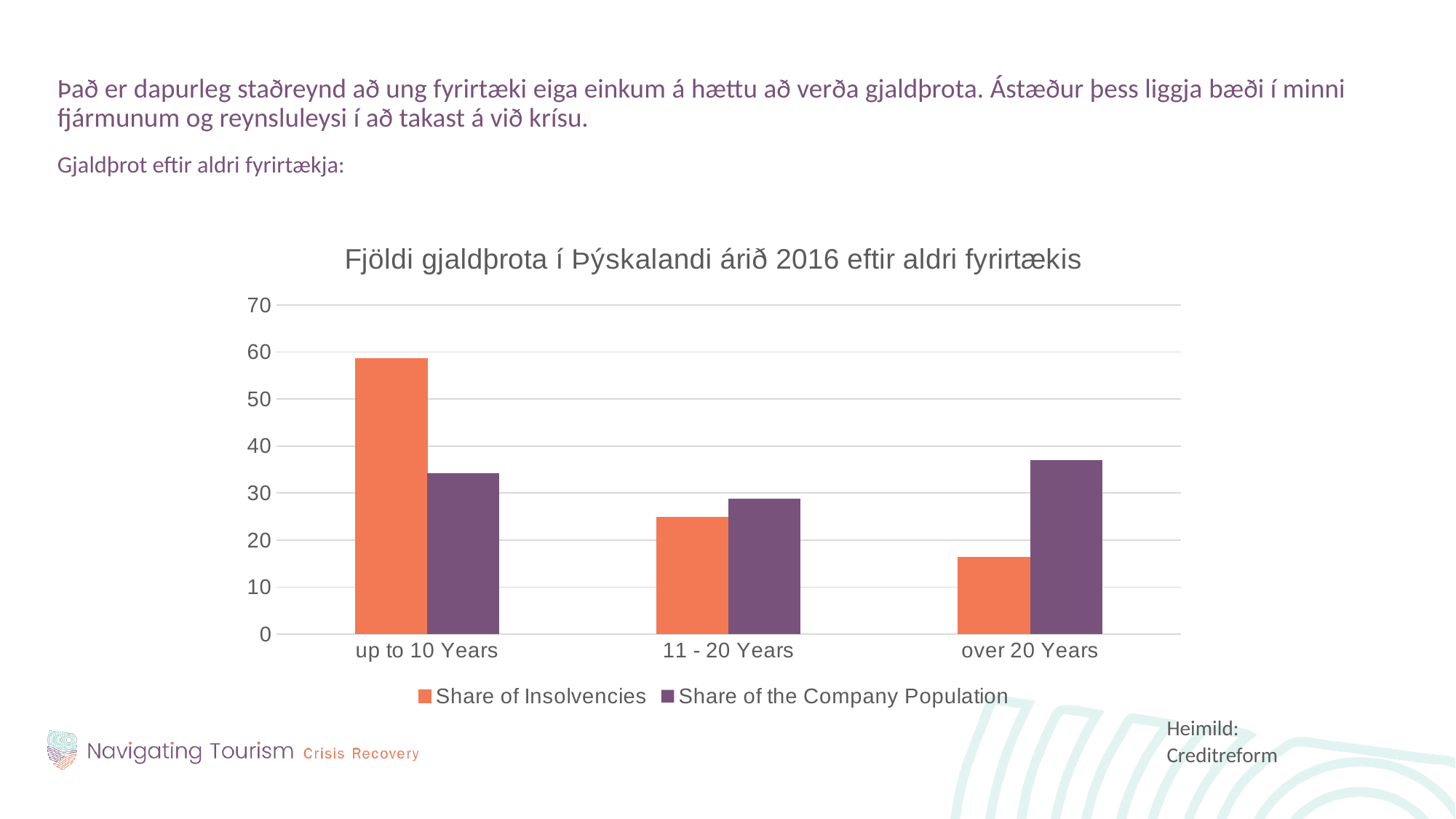
For over 20 Years, which is larger: Share of Insolvencies or Share of the Company Population? Share of the Company Population Which category has the highest Share of Insolvencies? up to 10 Years How many age categories are shown on the x axis? 3 Does the Share of Insolvencies rise or fall as company age increases along the x axis? fall Which category has the highest Share of the Company Population? over 20 Years What kind of chart is shown on the slide? bar chart Is the Share of the Company Population for over 20 Years greater or less than 30? greater Is the Share of Insolvencies for over 20 Years greater or less than 20? less Is the Share of Insolvencies for up to 10 Years greater or less than 50? greater Which category has the lowest Share of Insolvencies? over 20 Years For up to 10 Years, which is larger: Share of Insolvencies or Share of the Company Population? Share of Insolvencies How many series does the legend list? 2